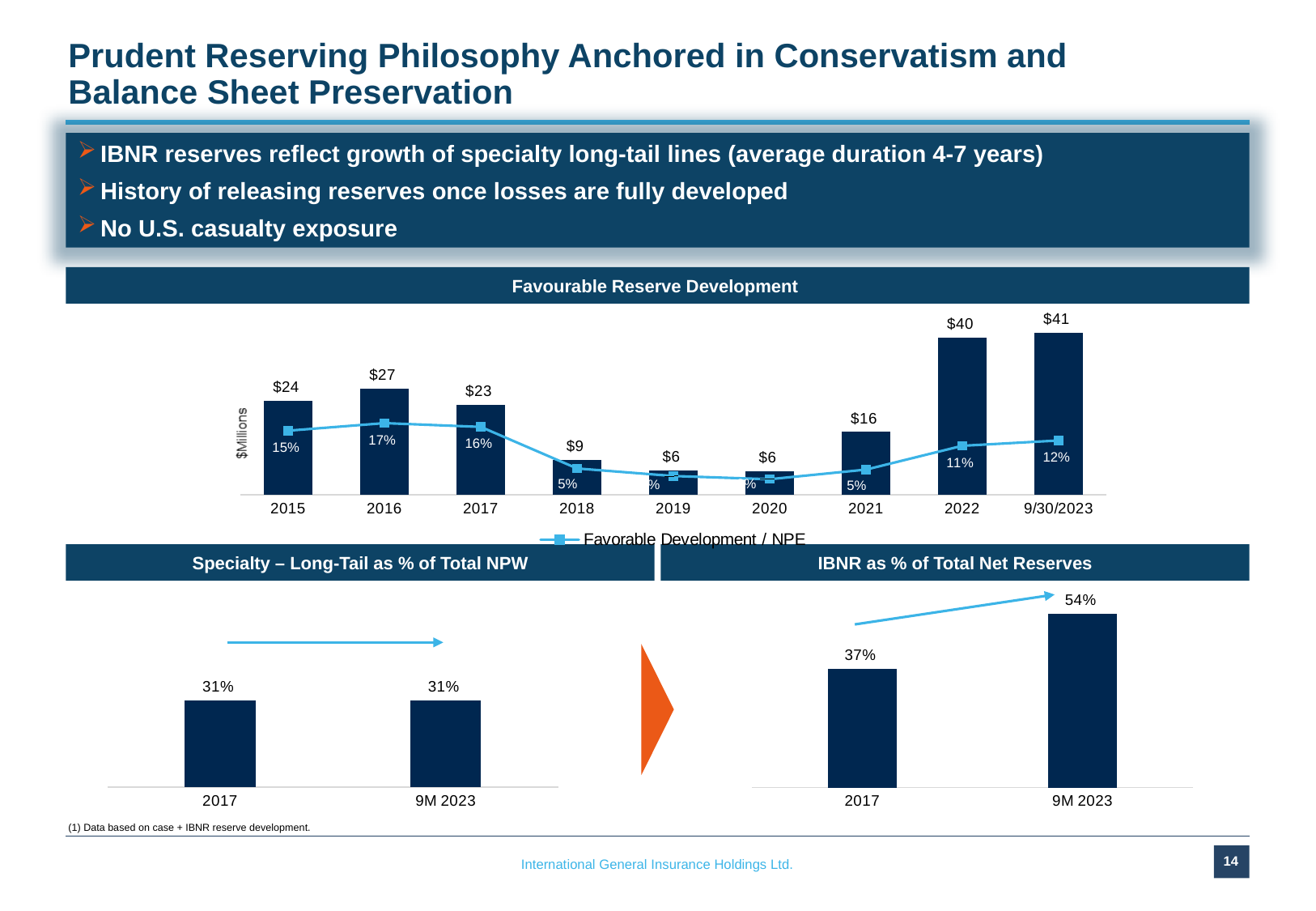
In the IBNR as % of Total Net Reserves chart, what is the difference between 9M 2023 and 2017? 17% In the Favourable Reserve Development chart, how many periods are shown on the x axis? 9 In the Favourable Reserve Development chart, what is the value for 2016? $27 In the Favourable Reserve Development chart, which period has the highest bar value? 9/30/2023 What type of chart is the IBNR as % of Total Net Reserves chart? bar chart In the Favourable Reserve Development chart, which year has the lowest bar value? 2019 and 2020 ($6) In the Favourable Reserve Development chart, what is the difference between the 2022 and 2021 bar values? $24 In the Favourable Reserve Development chart, what is the name of the line series shown in the legend? Favorable Development / NPE In the Specialty – Long-Tail as % of Total NPW chart, what is the value for 9M 2023? 31% In the Favourable Reserve Development chart, is the bar value for 2017 larger or smaller than the bar value for 2018? larger In the Favourable Reserve Development chart, what is the value for 9/30/2023? $41 In the Favourable Reserve Development chart, what is the Favorable Development / NPE percentage for 2016? 17%